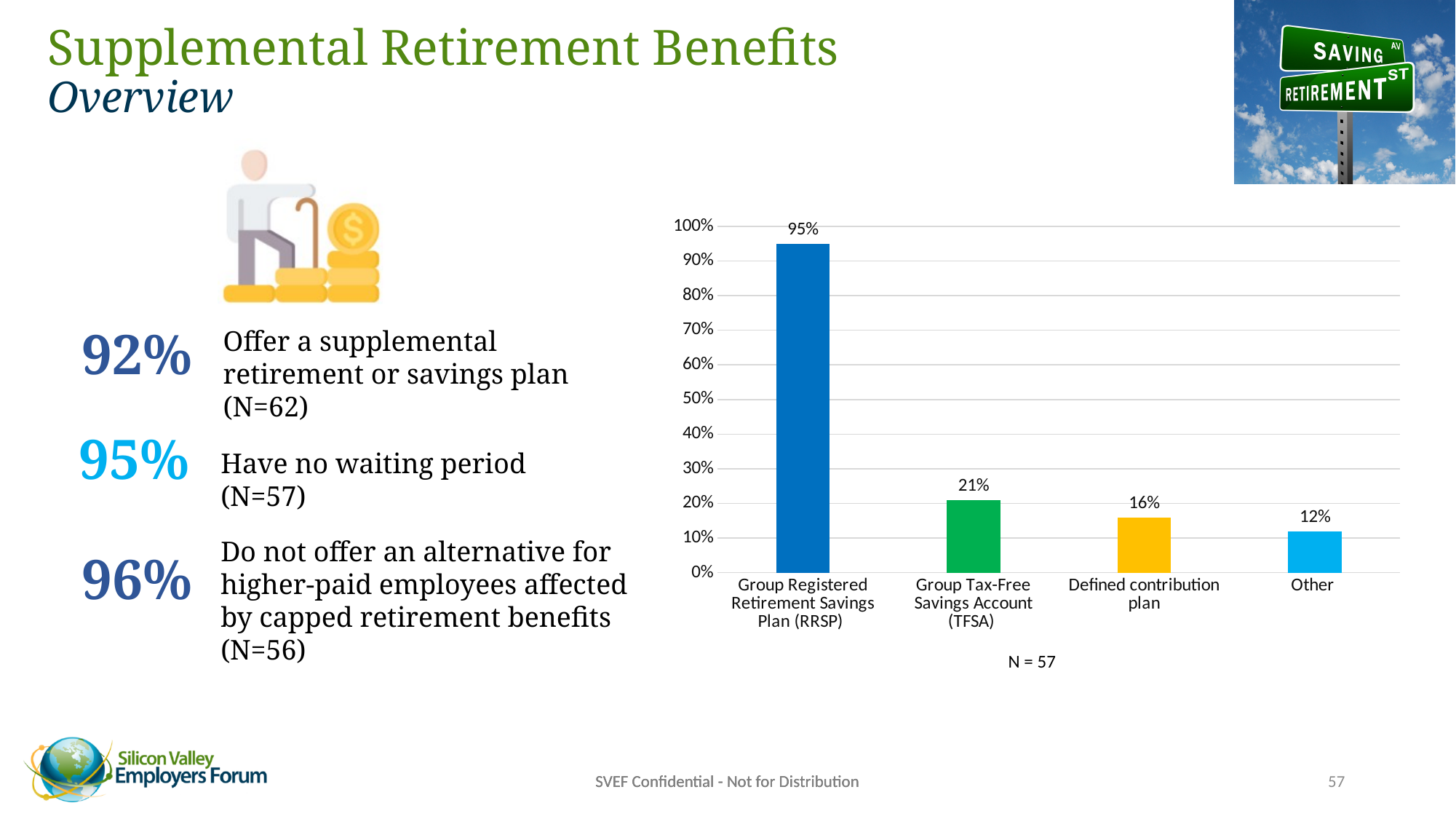
What kind of chart is shown on the slide? bar chart What is the value for Group Registered Retirement Savings Plan (RRSP)? 95% Which is larger, the value for Defined contribution plan or the value for Other? Defined contribution plan How many categories are shown in the chart? 4 Which category has the highest value? Group Registered Retirement Savings Plan (RRSP) What is the sample size (N) noted below the chart? N = 57 Is the value for Group Tax-Free Savings Account (TFSA) greater or less than 30%? less What is the value for Group Tax-Free Savings Account (TFSA)? 21% What is the value for Defined contribution plan? 16% Which category has the lowest value? Other What is the difference between the values for Group Registered Retirement Savings Plan (RRSP) and Group Tax-Free Savings Account (TFSA)? 74% What is the value for Other? 12%